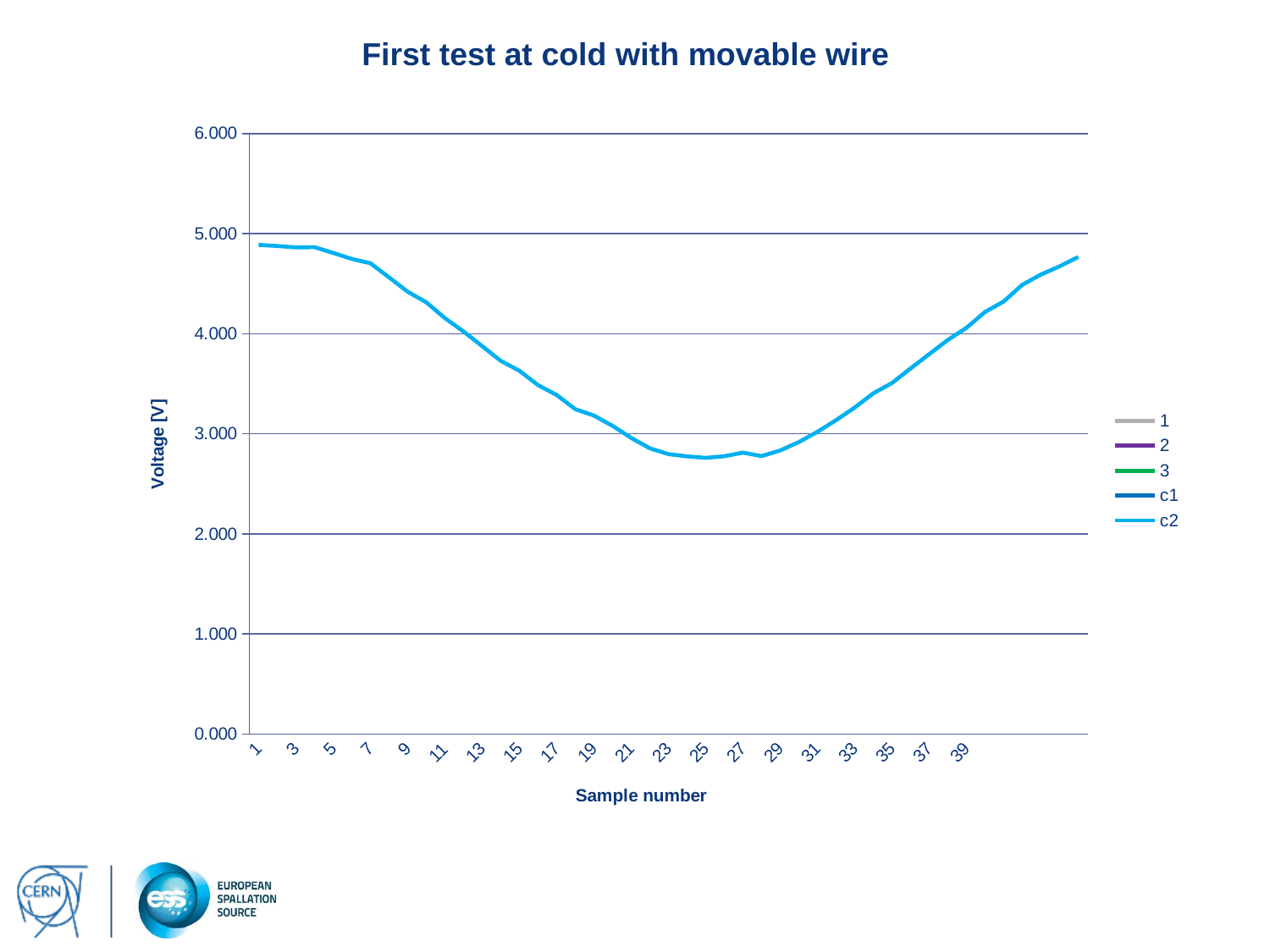
What kind of chart is shown on the slide? line chart Do the values rise or fall from sample number 1 to sample number 21? fall What is the label of the y axis? Voltage [V] Is the value at sample number 9 greater or less than 4.000? greater Is the value at sample number 35 greater or less than 3.000? greater Is the value at sample number 25 greater or less than 3.000? less What is the title of the chart? First test at cold with movable wire Which has the larger value, sample number 5 or sample number 15? sample number 5 How many series does the legend list? 5 Which has the larger value, sample number 25 or sample number 35? sample number 35